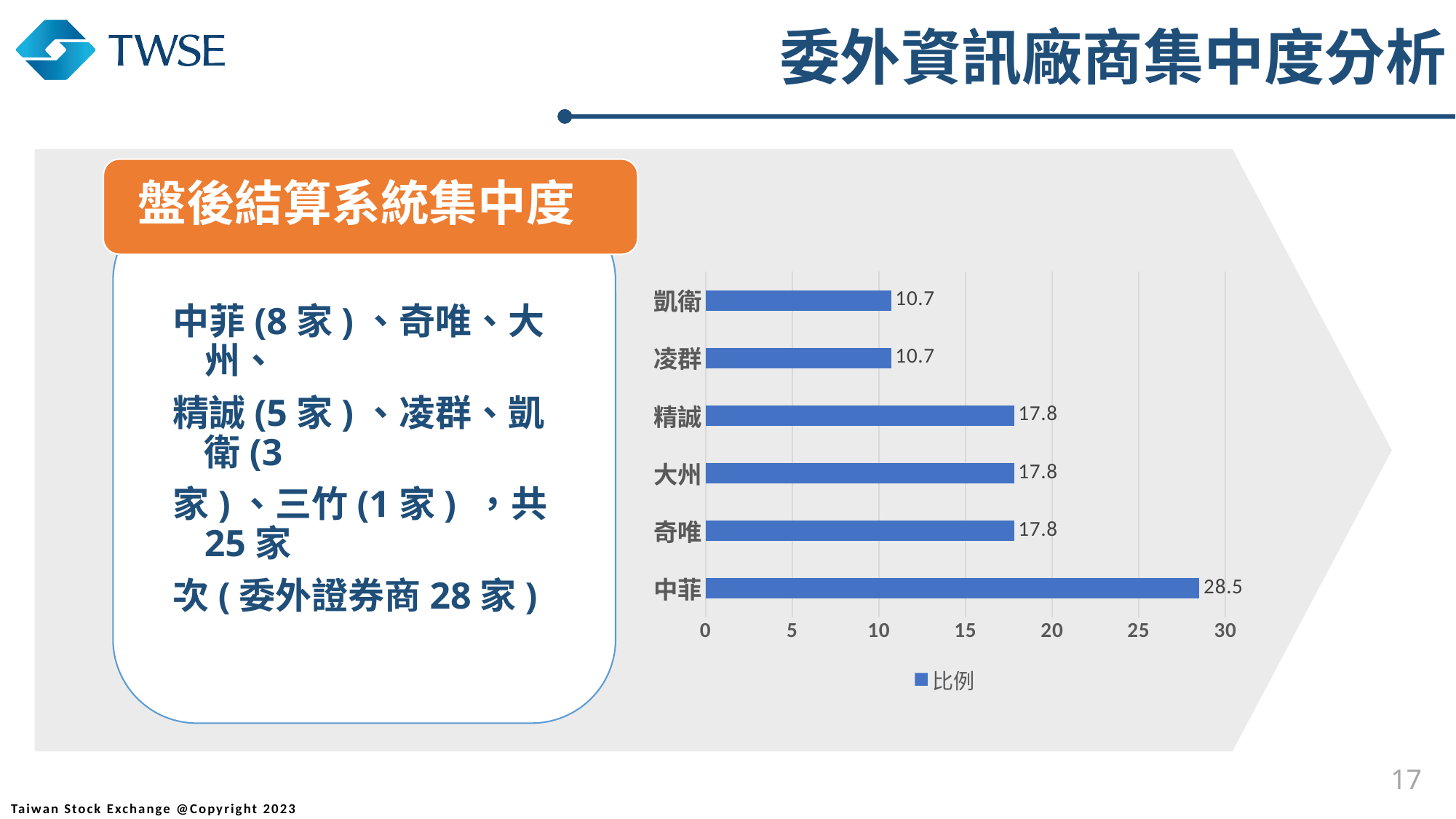
What is the difference between the values for 中菲 and 精誠? 10.7 What is the value for 大州? 17.8 Is the value for 中菲 greater or less than 25? greater What is the value for 凌群? 10.7 How many series does the legend list? 1 How many categories are shown in the chart? 6 What is the value for 中菲? 28.5 What is the difference between the values for 奇唯 and 凱衛? 7.1 What is the legend entry for the series in the chart? 比例 Which category has the highest value? 中菲 What kind of chart is shown on the slide? bar chart Which is larger, the value for 精誠 or the value for 凌群? 精誠